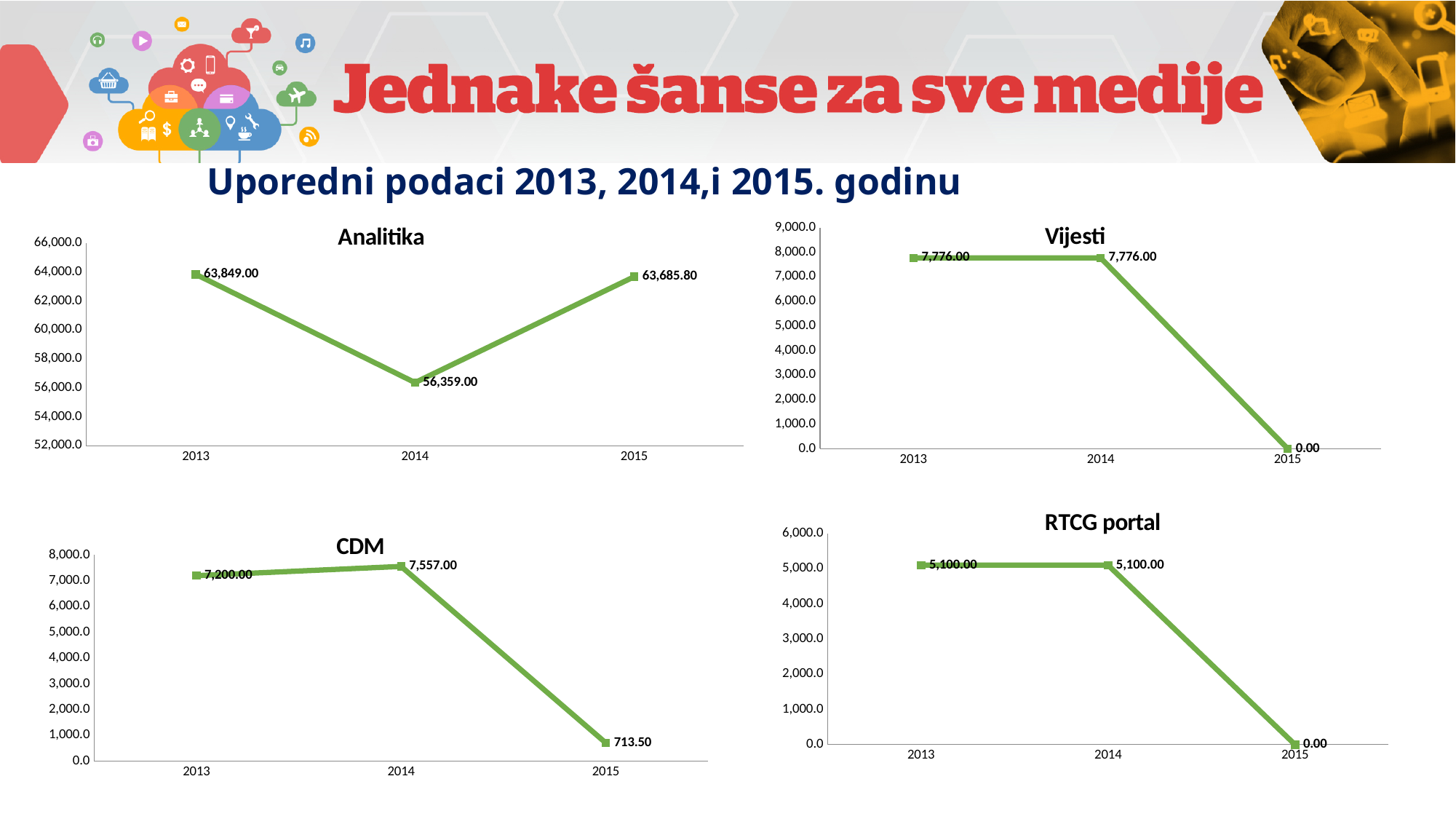
What kind of chart is the CDM chart? line chart In the Analitika chart, what is the difference between the 2013 and 2015 values? 163.20 In the CDM chart, which is larger, the value for 2013 or the value for 2014? 2014 How many years are plotted in the Vijesti chart? 3 In the Analitika chart, which year has the highest value? 2013 In the RTCG portal chart, do the values rise or fall from 2014 to 2015? fall In the Vijesti chart, which year has the lowest value? 2015 In the CDM chart, what is the value for 2015? 713.50 In the RTCG portal chart, what is the value for 2013? 5,100.00 In the Vijesti chart, what is the value for 2014? 7,776.00 In the CDM chart, what is the difference between the 2014 and 2013 values? 357.00 In the Analitika chart, what is the value for 2014? 56,359.00